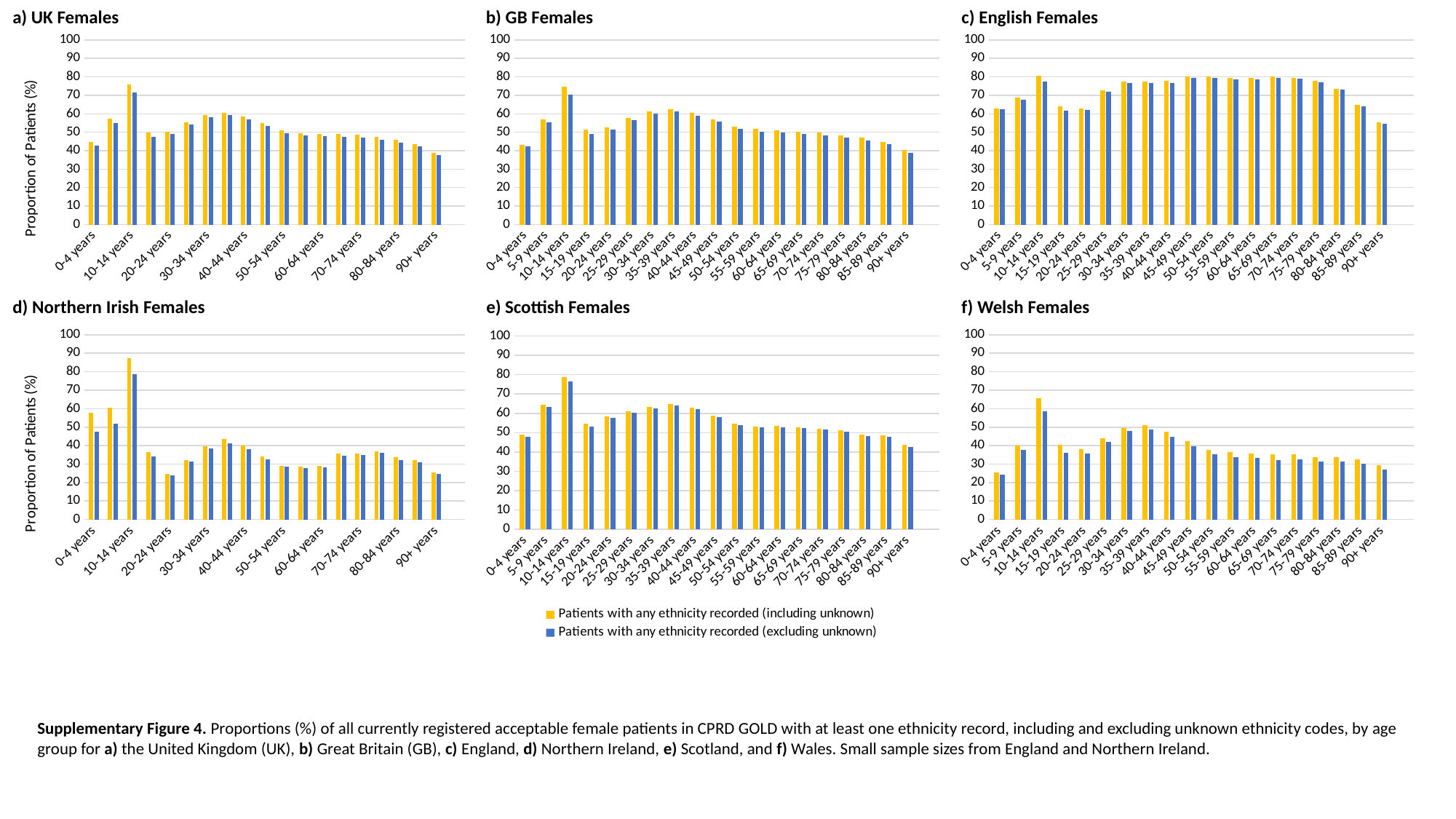
In the 'f) Welsh Females' chart, is the value for 0-4 years (including unknown) greater or less than 30? less How many series does the legend list for these charts? 2 In the 'c) English Females' chart, is the value for 90+ years (including unknown) greater or less than 60? less In the 'e) Scottish Females' chart, which age group has the highest proportion of patients? 10-14 years In the 'd) Northern Irish Females' chart, which is larger: the value for 10-14 years or the value for 20-24 years? 10-14 years What kind of chart is 'a) UK Females'? bar chart In the 'd) Northern Irish Females' chart, is the value for 10-14 years (including unknown) greater or less than 80? greater How many age groups are shown on the x axis of the 'f) Welsh Females' chart? 19 In the 'c) English Females' chart, which age group has the lowest proportion of patients? 90+ years In the 'a) UK Females' chart, which age group has the lowest proportion of patients? 90+ years In the 'a) UK Females' chart, which age group has the highest proportion of patients? 10-14 years